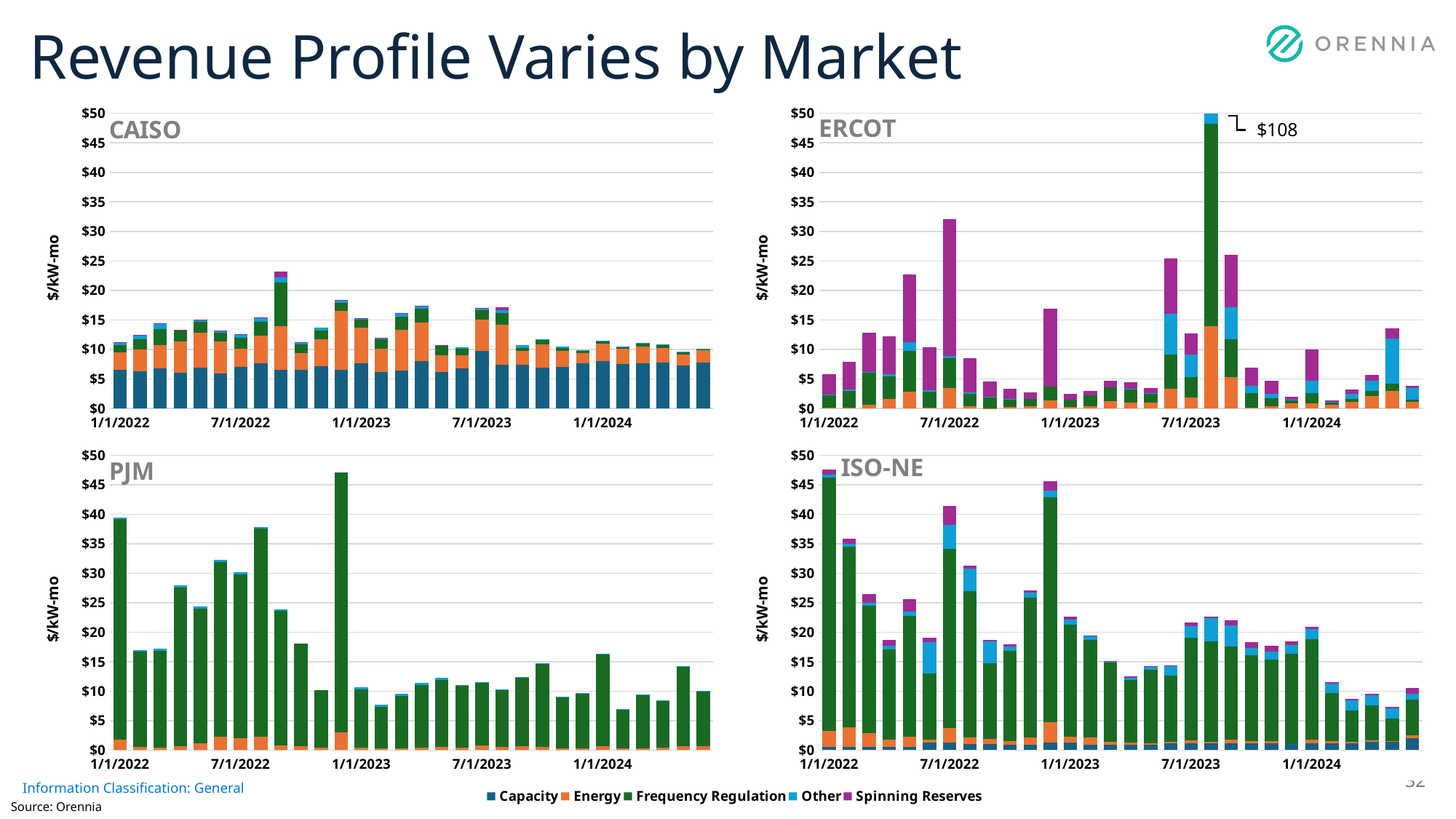
In the ERCOT chart, is the value for 7/1/2022 greater or less than $25? greater In the ISO-NE chart, is the value for 1/1/2022 greater or less than $40? greater How many series does the legend at the bottom of the slide list? 5 In the PJM chart, is the value of the tallest bar greater or less than $40? greater In the PJM chart, which is larger, the value for 1/1/2022 or the value for 7/1/2022? 1/1/2022 How many charts are shown on the slide? 4 What is the y-axis label on the CAISO chart? $/kW-mo Across the four charts, which market has the single highest bar? ERCOT What kind of chart is the CAISO chart? Stacked bar chart In the ERCOT chart, what value is printed as the data label on the tallest bar? $108 What colour represents Spinning Reserves in the legend? Purple